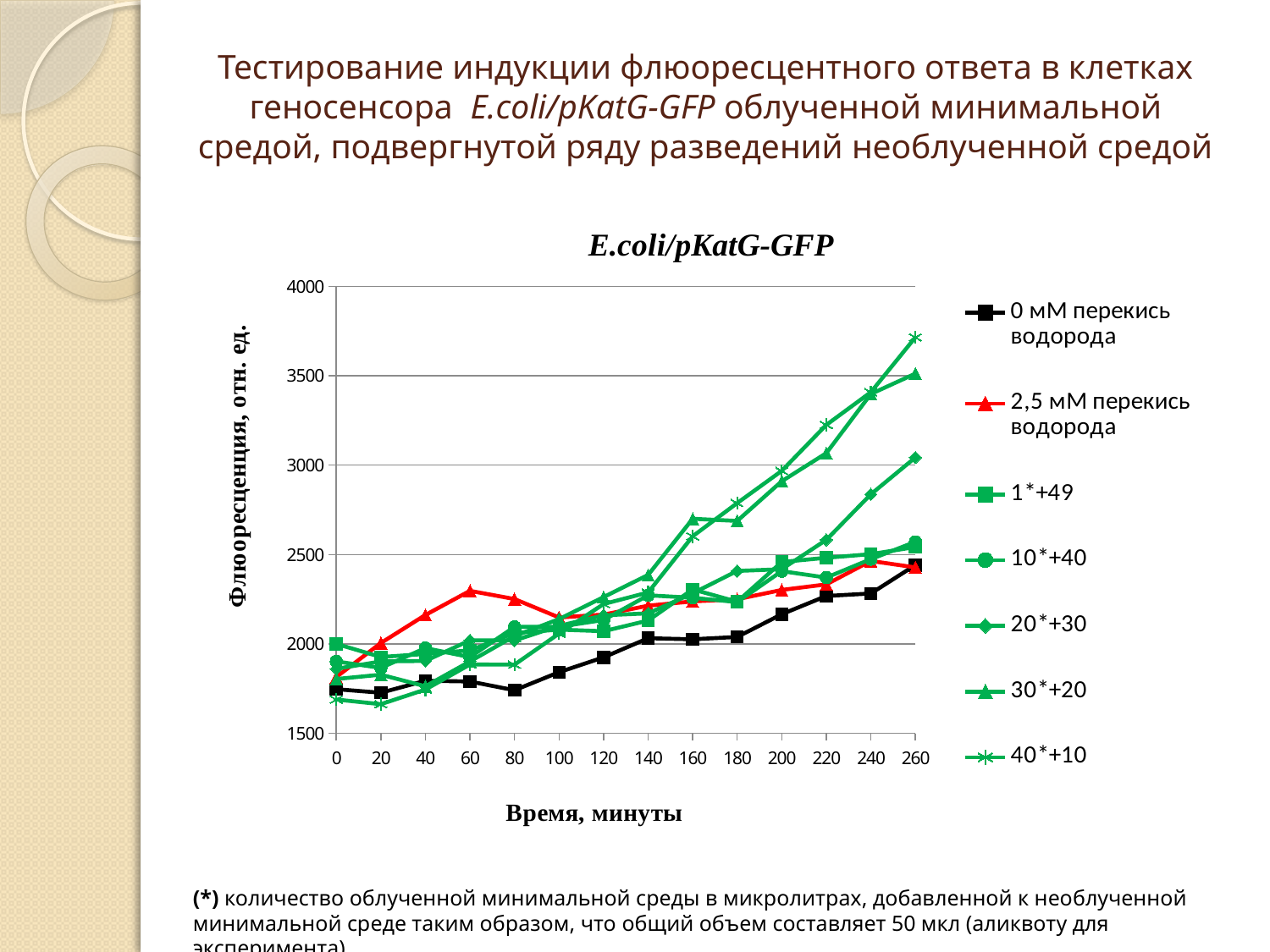
Is the value for 40*+10 at 260 minutes greater or less than 3500? greater How many time points are marked on the x axis? 14 How many series does the legend list? 7 What is the title of the chart? E.coli/pKatG-GFP Which series has the highest value at 260 minutes? 40*+10 What kind of chart is shown on the slide? line chart Is the value for 0 мМ перекись водорода at 0 minutes greater or less than 2000? less Is the value for 30*+20 at 260 minutes greater or less than 3000? greater Does the value for 40*+10 generally rise or fall from 0 to 260 minutes? rise At 260 minutes, which is larger: the value for 30*+20 or the value for 20*+30? 30*+20 What is the label of the x axis? Время, минуты